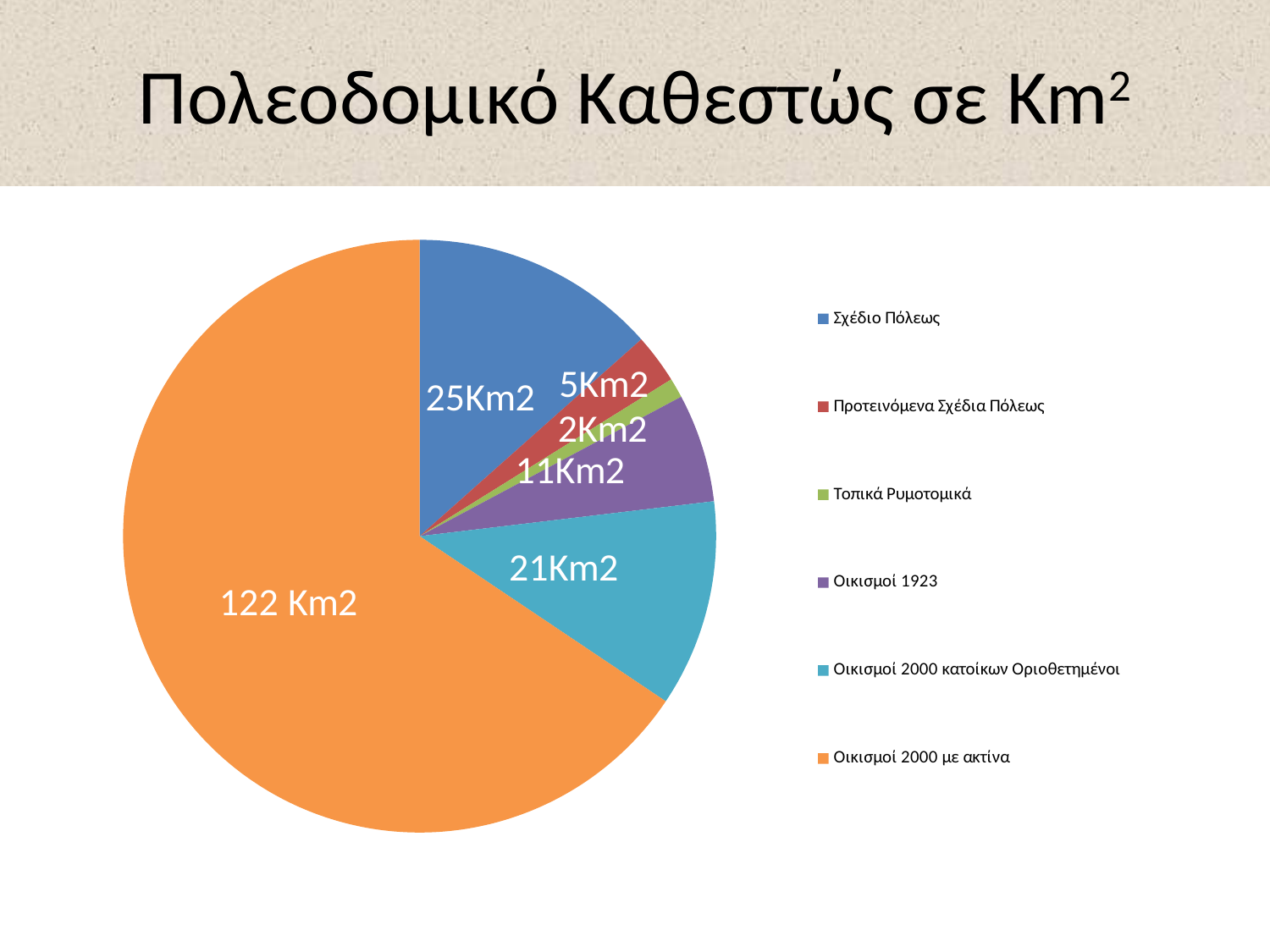
What kind of chart is shown on the slide? pie chart What is the value for Τοπικά Ρυμοτομικά? 2Km2 What is the value for Οικισμοί 1923? 11Km2 What colour is the slice for Οικισμοί 2000 κατοίκων Οριοθετημένοι? teal (light blue) How many categories does the pie chart have? 6 What is the title of the slide? Πολεοδομικό Καθεστώς σε Km2 Which category has the smallest slice of the pie? Τοπικά Ρυμοτομικά What is the difference between the values for Σχέδιο Πόλεως and Οικισμοί 2000 κατοίκων Οριοθετημένοι? 4Km2 What is the value for Σχέδιο Πόλεως? 25Km2 Which category has the largest slice of the pie? Οικισμοί 2000 με ακτίνα Which is larger, the value for Προτεινόμενα Σχέδια Πόλεως or the value for Οικισμοί 1923? Οικισμοί 1923 What is the value for Οικισμοί 2000 με ακτίνα? 122 Km2